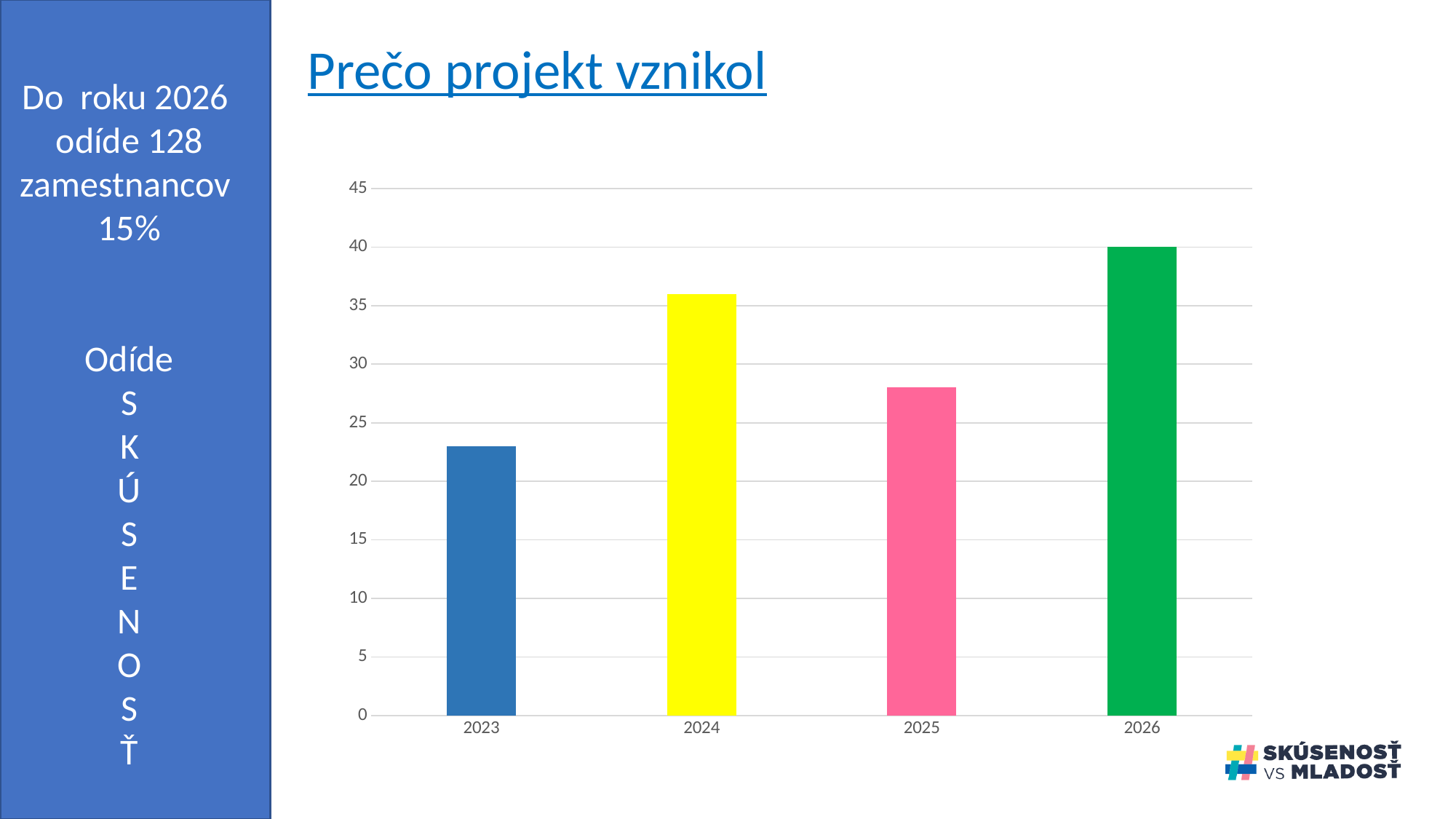
Which year has the lowest bar in the chart? 2023 What is the value for 2026 in the chart? 40 Which year has the highest bar in the chart? 2026 What colour is the bar for 2024? yellow Is the value for 2025 greater or less than 30? less Is the value for 2023 greater or less than 25? less Which is larger, the value for 2023 or the value for 2025? 2025 What is the title shown above the chart on the slide? Prečo projekt vznikol How many bars (years) does the chart show? 4 Is the value for 2024 greater or less than 35? greater Which is larger, the value for 2024 or the value for 2025? 2024 What kind of chart is shown on the slide? bar chart